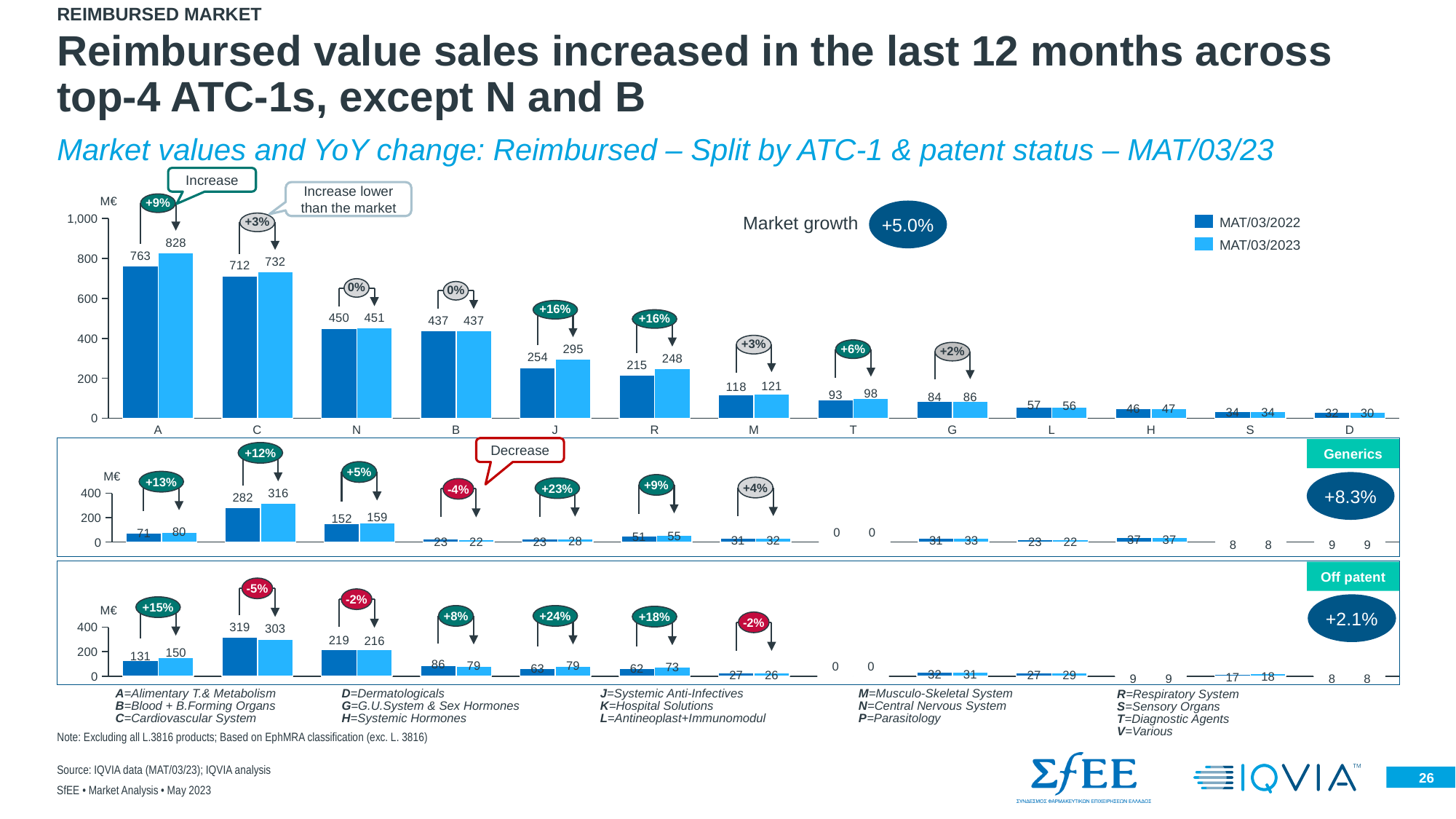
In the Off patent chart, which is larger for category C: the MAT/03/2022 value or the MAT/03/2023 value? MAT/03/2022 In the top chart, is the MAT/03/2023 value for category N greater or less than 400? greater What market growth figure is shown next to the top chart? +5.0% In the Generics chart, what is the MAT/03/2023 value for category C? 316 What kind of chart is the top chart? Bar chart In the top chart, what is the MAT/03/2023 value for category A? 828 How many series does the legend of the top chart list? 2 In the top chart, what is the difference between the MAT/03/2023 and MAT/03/2022 values for category J? 41 In the Generics chart, what YoY change is shown for category B? -4% How many categories are shown on the x axis of the top chart? 13 In the Off patent chart, what is the MAT/03/2022 value for category N? 219 In the top chart, which category has the highest MAT/03/2023 value? A